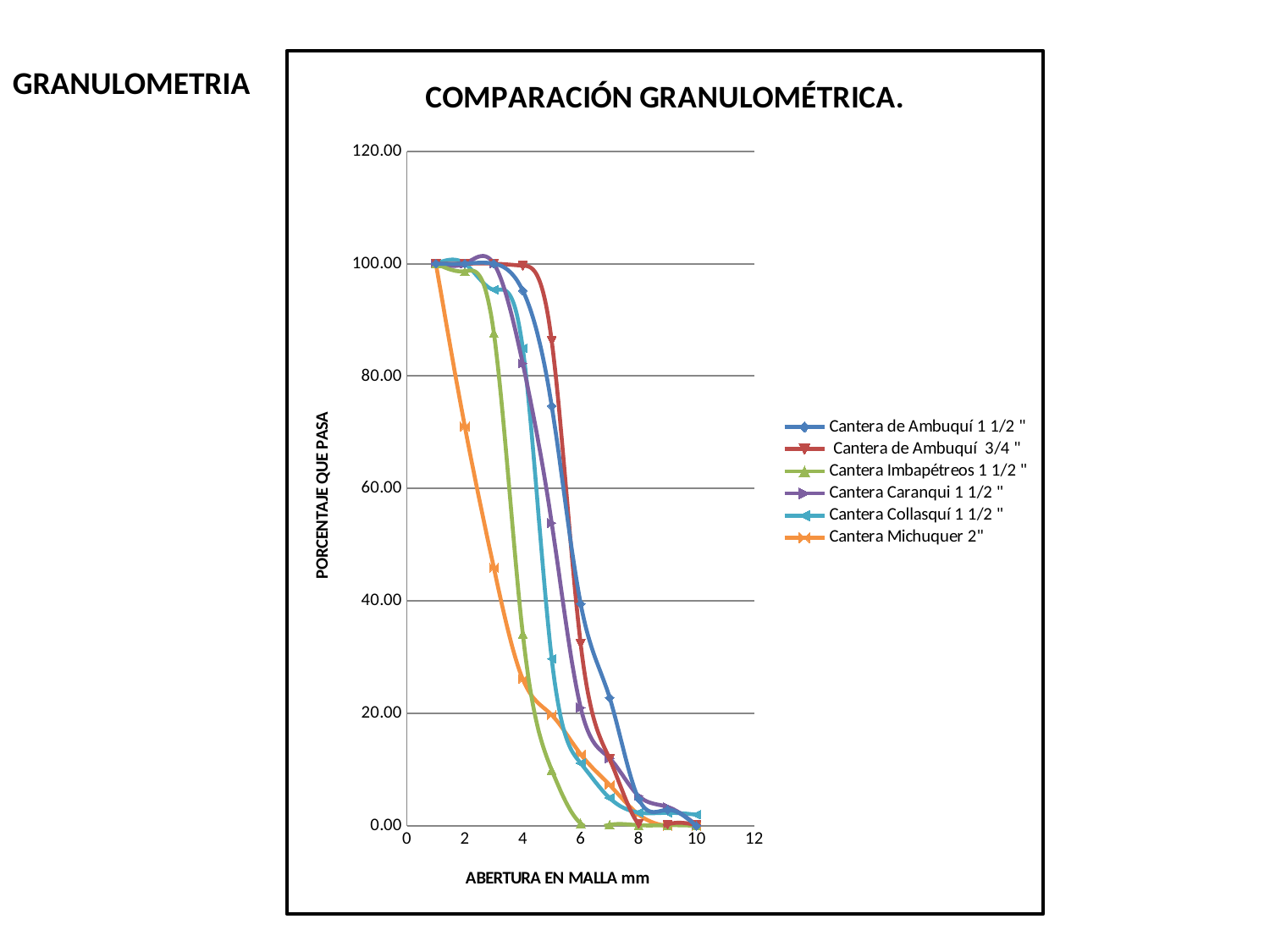
Is the value for Cantera Collasquí 1 1/2" at x = 4 greater or less than 80? greater Is the value for Cantera Imbapétreos 1 1/2" at x = 4 greater or less than 40? less Do the values for Cantera Michuquer 2" rise or fall as the x axis increases? fall Is the value for Cantera de Ambuquí 3/4" at x = 5 greater or less than 80? greater How many series does the legend list? 6 What is the label of the x axis? ABERTURA EN MALLA mm Which series has the lowest value at x = 4? Cantera Michuquer 2" What is the title of the chart? COMPARACIÓN GRANULOMÉTRICA. At x = 2, which is larger: the value for Cantera Michuquer 2" or the value for Cantera Imbapétreos 1 1/2"? Cantera Imbapétreos 1 1/2" What kind of chart is shown on the slide? line chart